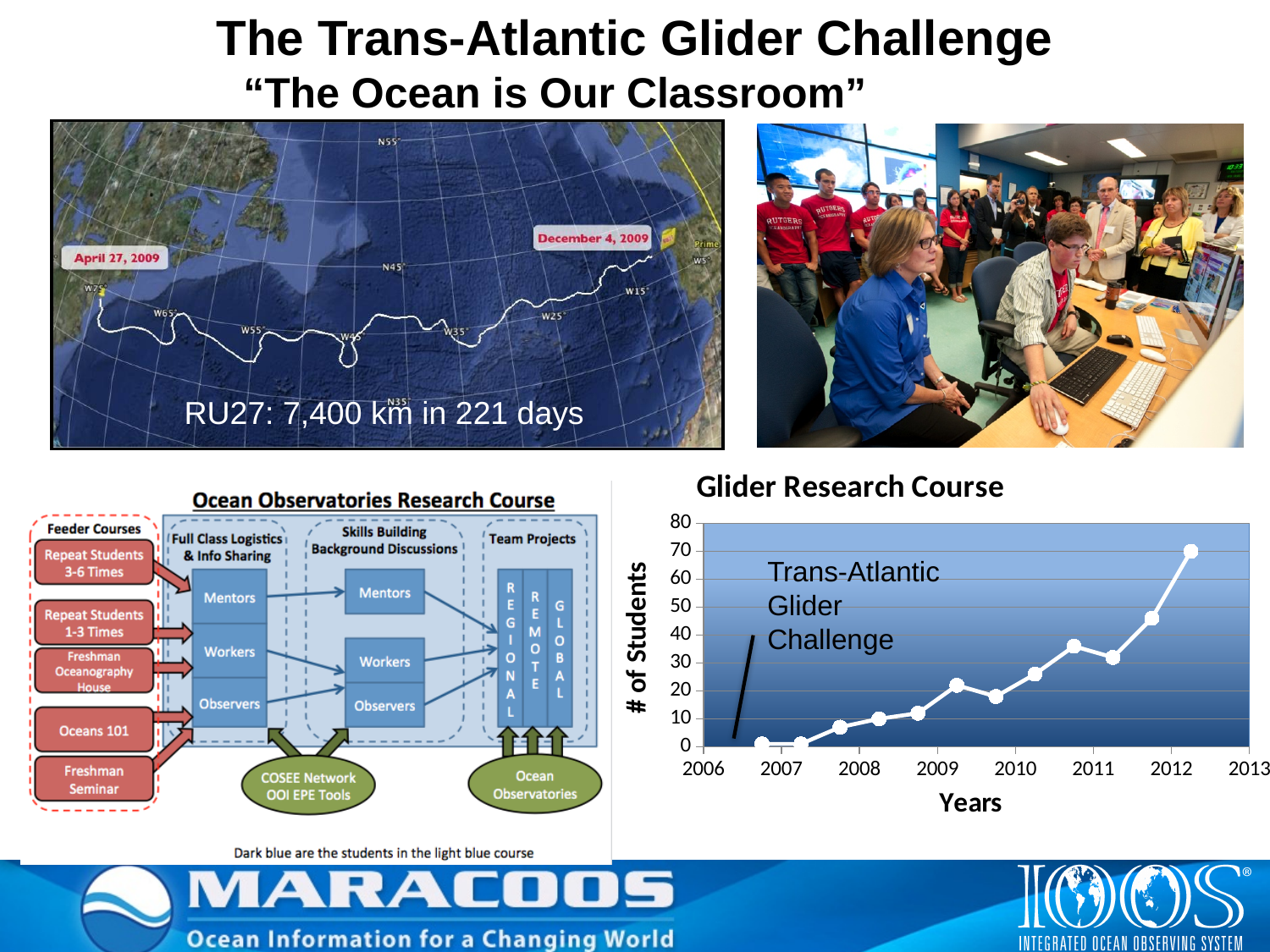
In the "Glider Research Course" chart, is the value in 2012 larger or smaller than the value in 2010? larger In the "Glider Research Course" chart, in which year does the highest number of students occur? 2012 In the "Glider Research Course" chart, do the values generally rise or fall from 2006 to 2013? rise In the "Glider Research Course" chart, what is the title of the x axis? Years In the "Glider Research Course" chart, is the value plotted in early 2010 greater or less than 20? greater How many data points are plotted in the "Glider Research Course" chart? 12 In the "Glider Research Course" chart, is the highest plotted value greater or less than 60? greater In the "Glider Research Course" chart, what is the title of the y axis? # of Students In the "Glider Research Course" chart, are the values plotted during 2007 greater or less than 10? less What kind of chart is the "Glider Research Course" chart? line chart